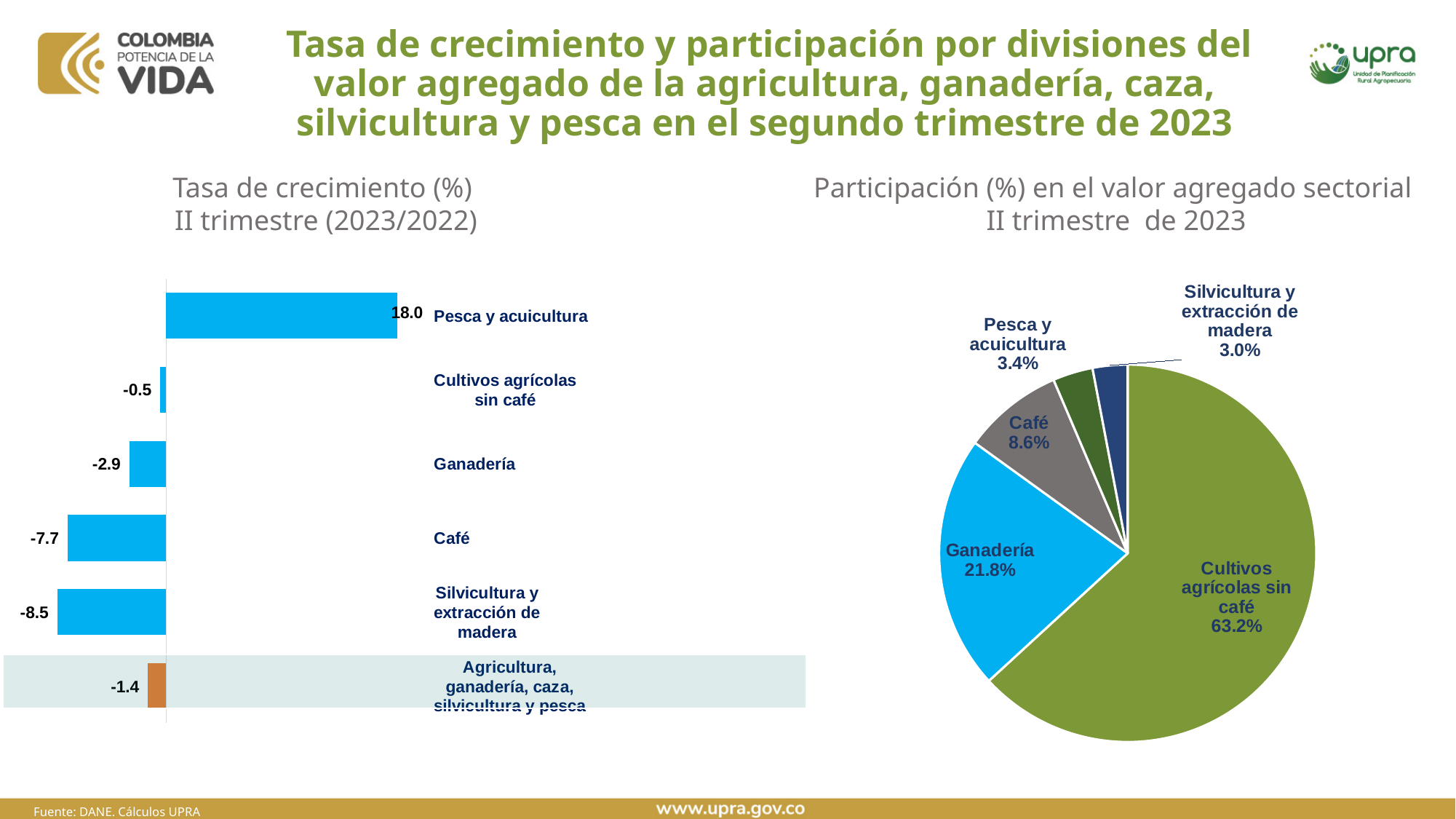
In the bar chart 'Tasa de crecimiento (%) II trimestre (2023/2022)', which category has the highest growth rate? Pesca y acuicultura In the bar chart 'Tasa de crecimiento (%) II trimestre (2023/2022)', which category has the lowest growth rate? Silvicultura y extracción de madera In the bar chart 'Tasa de crecimiento (%) II trimestre (2023/2022)', how many categories are shown? 6 In the pie chart 'Participación (%) en el valor agregado sectorial II trimestre de 2023', which division has the largest share? Cultivos agrícolas sin café In the bar chart 'Tasa de crecimiento (%) II trimestre (2023/2022)', what is the growth rate for Pesca y acuicultura? 18.0 What type of chart is the one on the left of the slide? Bar chart In the pie chart 'Participación (%) en el valor agregado sectorial II trimestre de 2023', which is larger, the share of Café or the share of Pesca y acuicultura? Café In the bar chart 'Tasa de crecimiento (%) II trimestre (2023/2022)', what is the value for Agricultura, ganadería, caza, silvicultura y pesca? -1.4 In the pie chart 'Participación (%) en el valor agregado sectorial II trimestre de 2023', what is the share of Ganadería? 21.8% In the bar chart 'Tasa de crecimiento (%) II trimestre (2023/2022)', what is the growth rate for Café? -7.7 In the pie chart 'Participación (%) en el valor agregado sectorial II trimestre de 2023', how many slices are there? 5 In the bar chart 'Tasa de crecimiento (%) II trimestre (2023/2022)', what is the difference between the values for Ganadería and Café? 4.8